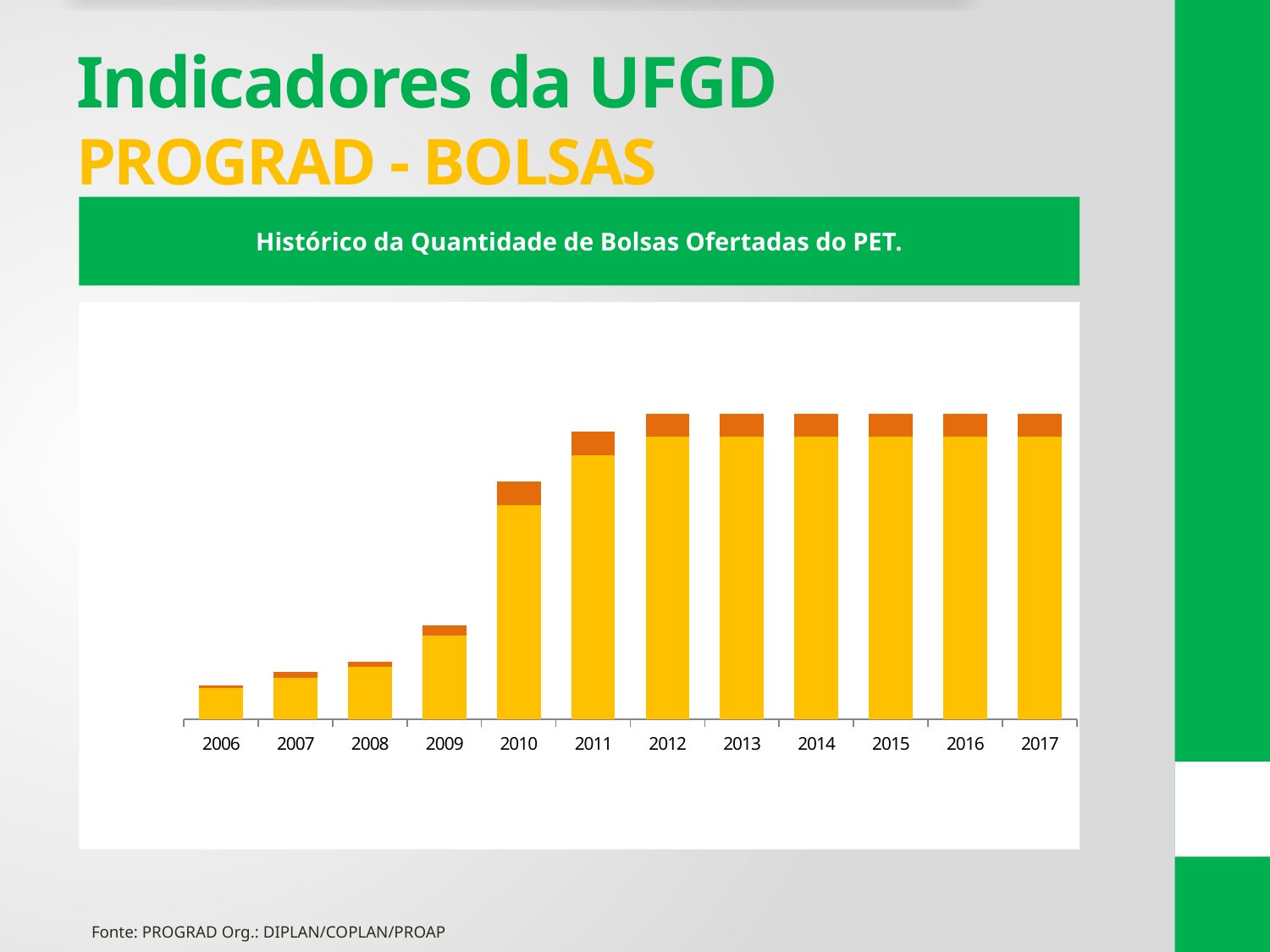
How many years are shown along the x axis of the chart? 12 Do the bar heights generally rise or fall from 2006 to 2012? Rise Is the bar for 2010 taller or shorter than the bar for 2009? Taller What is the title of the chart? Histórico da Quantidade de Bolsas Ofertadas do PET. Do the bar heights change noticeably between 2012 and 2017? No, they stay roughly level Is the bar for 2008 taller or shorter than the bar for 2012? Shorter What kind of chart is shown on the slide? Stacked bar chart What is the first year shown on the x axis? 2006 Is the bar for 2011 taller or shorter than the bar for 2010? Taller Which year has the lowest total bar in the chart? 2006